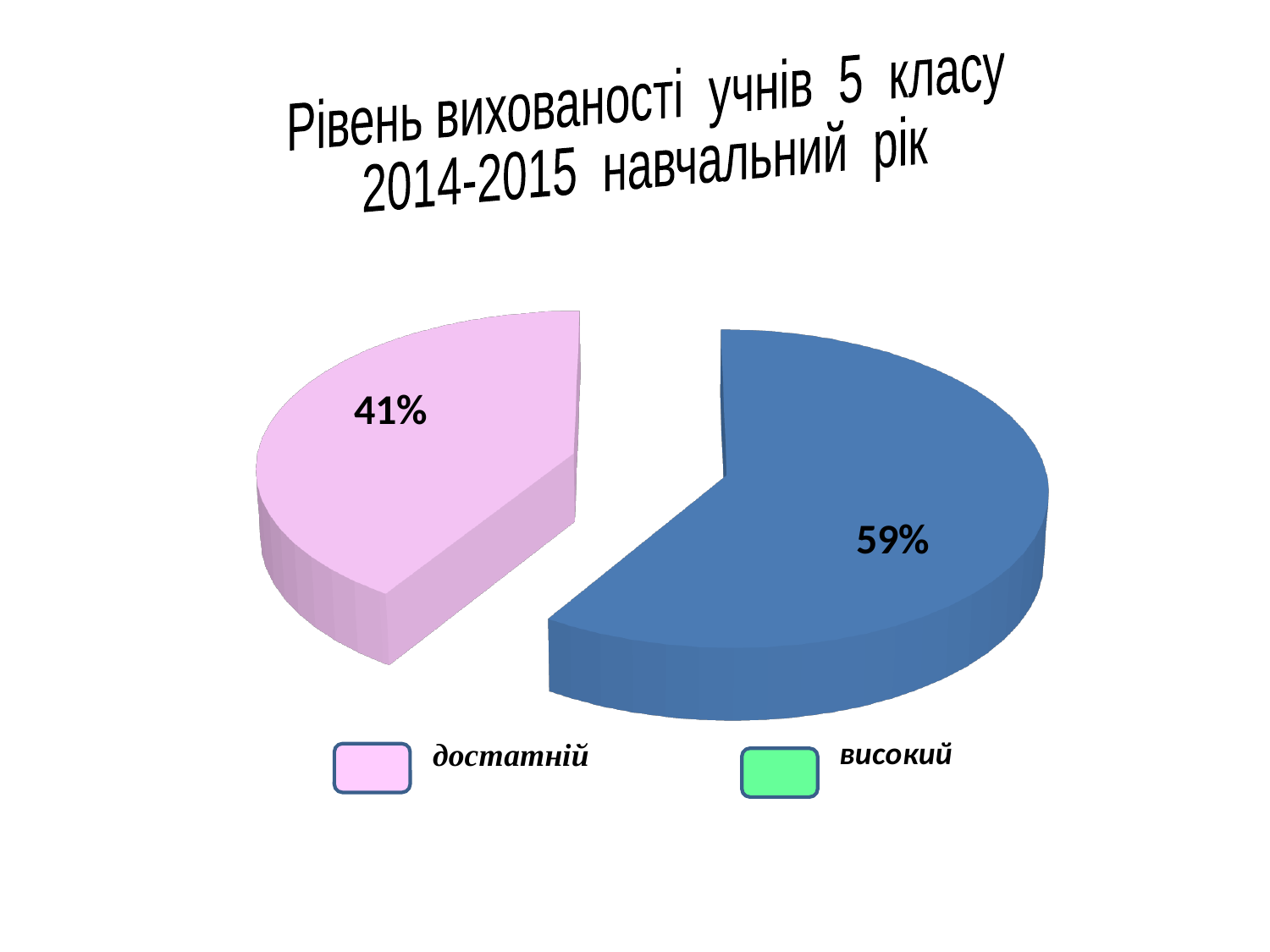
What percentage is shown on the blue slice of the pie chart? 59% What is the difference in percentage points between the високий and достатній slices? 18 What percentage is shown for the достатній slice of the pie chart? 41% What percentage is shown for the високий level in the pie chart? 59% Which category has the smallest slice in the pie chart? достатній What kind of chart is shown on the slide? pie chart How many entries does the legend list? 2 What is the title of the chart? Рівень вихованості учнів 5 класу 2014-2015 навчальний рік What colour is the slice labelled 41%? pink Which category has the largest slice in the pie chart? високий How many slices does the pie chart have? 2 Which level has the larger share of the pie chart, достатній or високий? високий